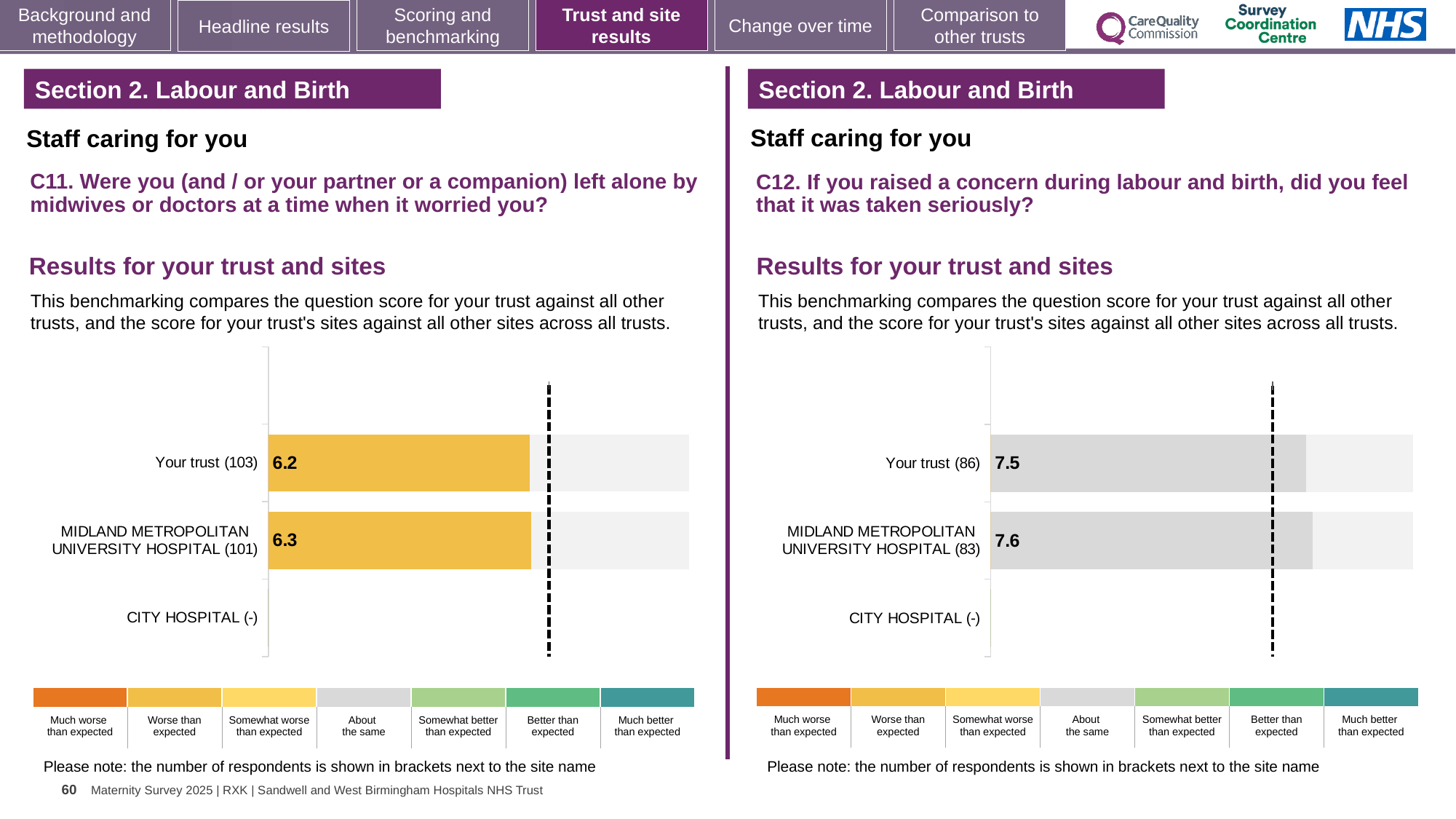
On the left chart (C11), what is the score for Your trust? 6.2 On the left chart (C11), which benchmark category colour are the bars for Your trust and Midland Metropolitan University Hospital shown in? Worse than expected What type of chart is used on the right (C12) to show the results? Bar chart On the right chart (C12), what is the difference between the Midland Metropolitan University Hospital score and the Your trust score? 0.1 On the right chart (C12), how many respondents are shown in brackets for Midland Metropolitan University Hospital? 83 On the left chart (C11), how many respondents are shown in brackets for Your trust? 103 On the right chart (C12), what is the score for Midland Metropolitan University Hospital? 7.6 On the left chart (C11), what is the score for Midland Metropolitan University Hospital? 6.3 On the left chart (C11), what is the difference between the Midland Metropolitan University Hospital score and the Your trust score? 0.1 On the right chart (C12), what is the score for Your trust? 7.5 On the right chart (C12), which benchmark category do the grey bars for Your trust and Midland Metropolitan University Hospital represent? About the same How many site/trust categories are listed on the left chart (C11)? 3